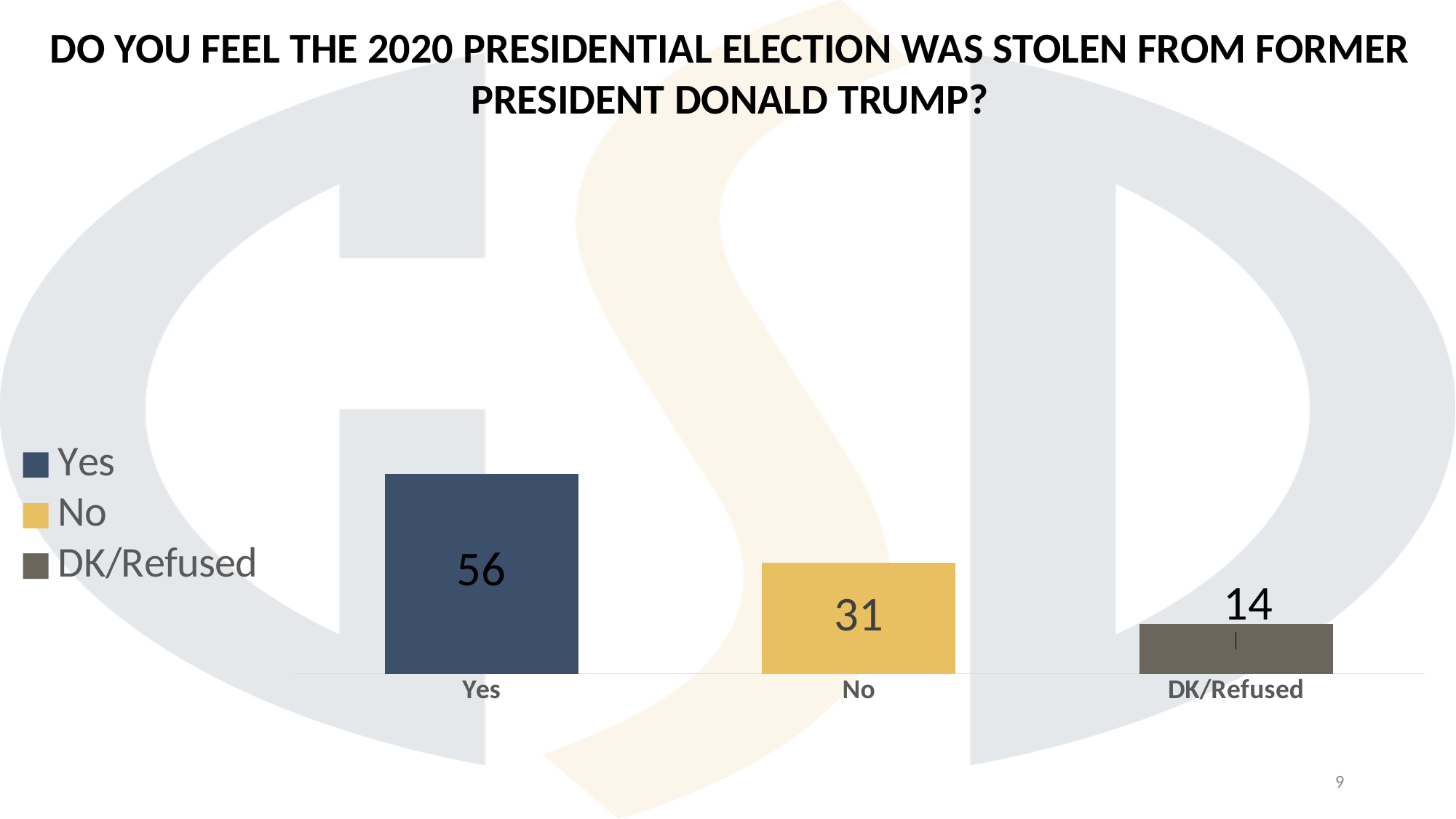
How many categories are shown in the chart? 3 What colour is the bar for No? Yellow What kind of chart is shown on the slide? Bar chart Which category has the highest value? Yes What is the value for No? 31 What is the difference between the values for No and DK/Refused? 17 What is the value for Yes? 56 How many entries does the legend list? 3 What is the difference between the values for Yes and No? 25 Which is larger, the value for Yes or the value for No? Yes What is the value for DK/Refused? 14 Which category has the lowest value? DK/Refused